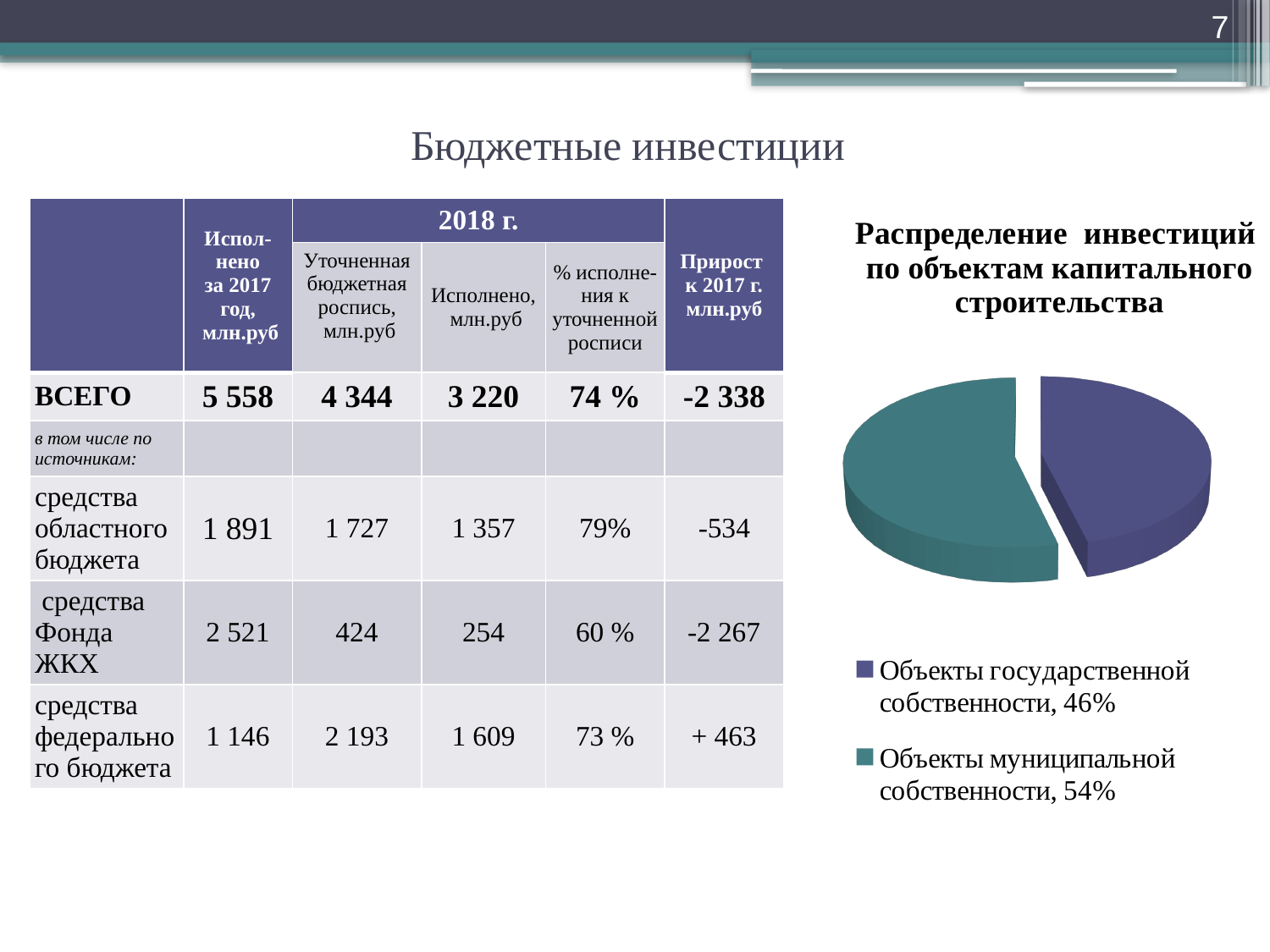
What is the title of the pie chart? Распределение инвестиций по объектам капитального строительства What share of the pie is 'Объекты государственной собственности'? 46% Which slice of the pie chart is the smallest? Объекты государственной собственности What share of the pie is 'Объекты муниципальной собственности'? 54% By how many percentage points does the share of 'Объекты муниципальной собственности' exceed that of 'Объекты государственной собственности'? 8 How many slices does the pie chart have? 2 Which is larger: the share for 'Объекты государственной собственности' or for 'Объекты муниципальной собственности'? Объекты муниципальной собственности Which slice of the pie chart is the largest? Объекты муниципальной собственности What kind of chart is shown on the slide? pie chart What colour is the slice for 'Объекты муниципальной собственности' in the pie chart? teal Is the share for 'Объекты государственной собственности' greater or less than 50%? less